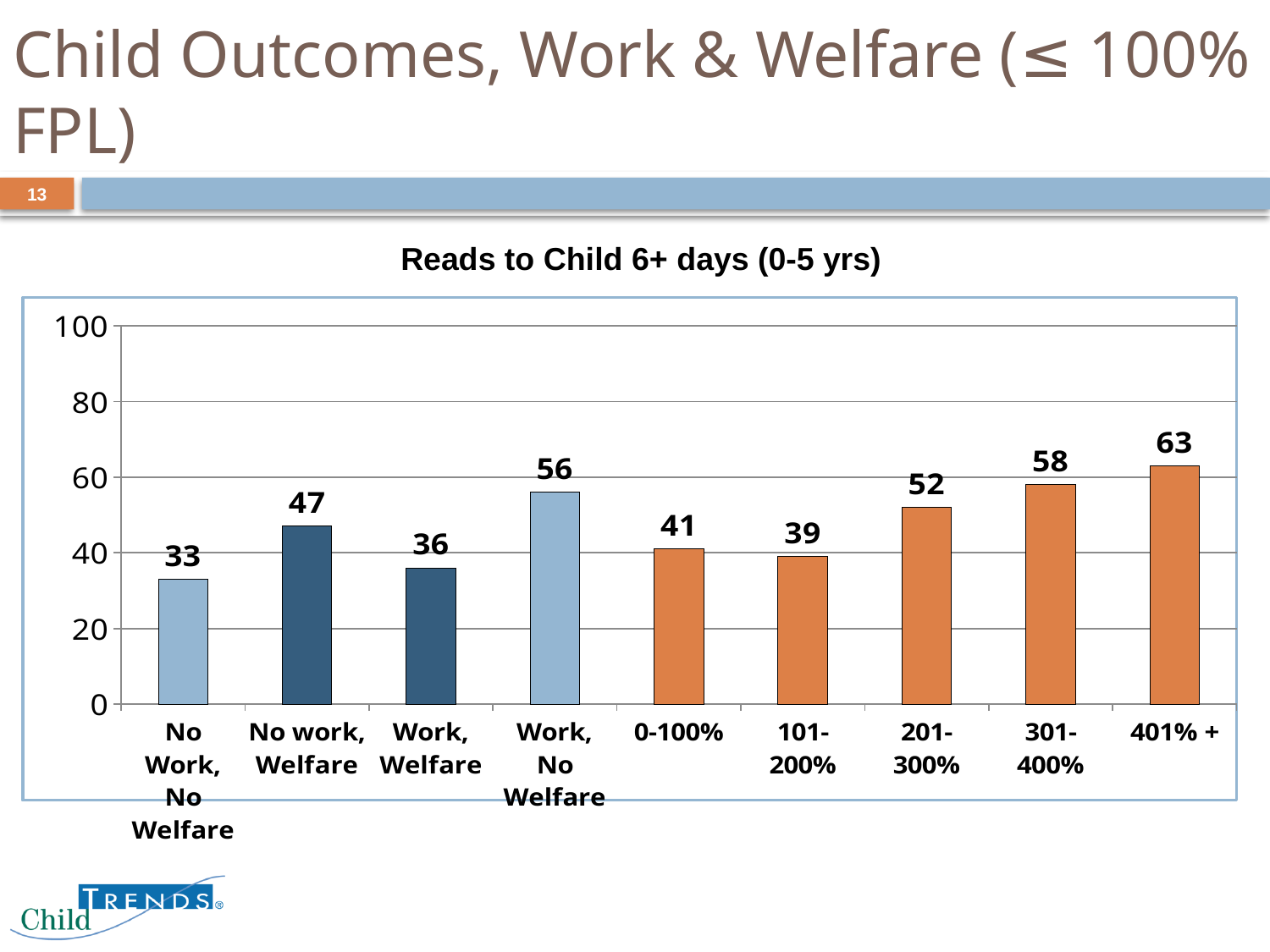
What is the title of the chart? Reads to Child 6+ days (0-5 yrs) What is the value for the '401% +' category? 63 What is the difference between the values for '401% +' and '0-100%'? 22 How many categories are shown on the x axis? 9 Is the value for '301-400%' greater or less than 40? greater What kind of chart is shown on the slide? bar chart What is the value for the 'No work, Welfare' category? 47 What is the value for the 'Work, No Welfare' category? 56 What is the difference between the values for 'Work, No Welfare' and 'Work, Welfare'? 20 Which is larger, the value for '0-100%' or the value for '101-200%'? 0-100% Which category has the lowest value? No Work, No Welfare Which category has the highest value? 401% +